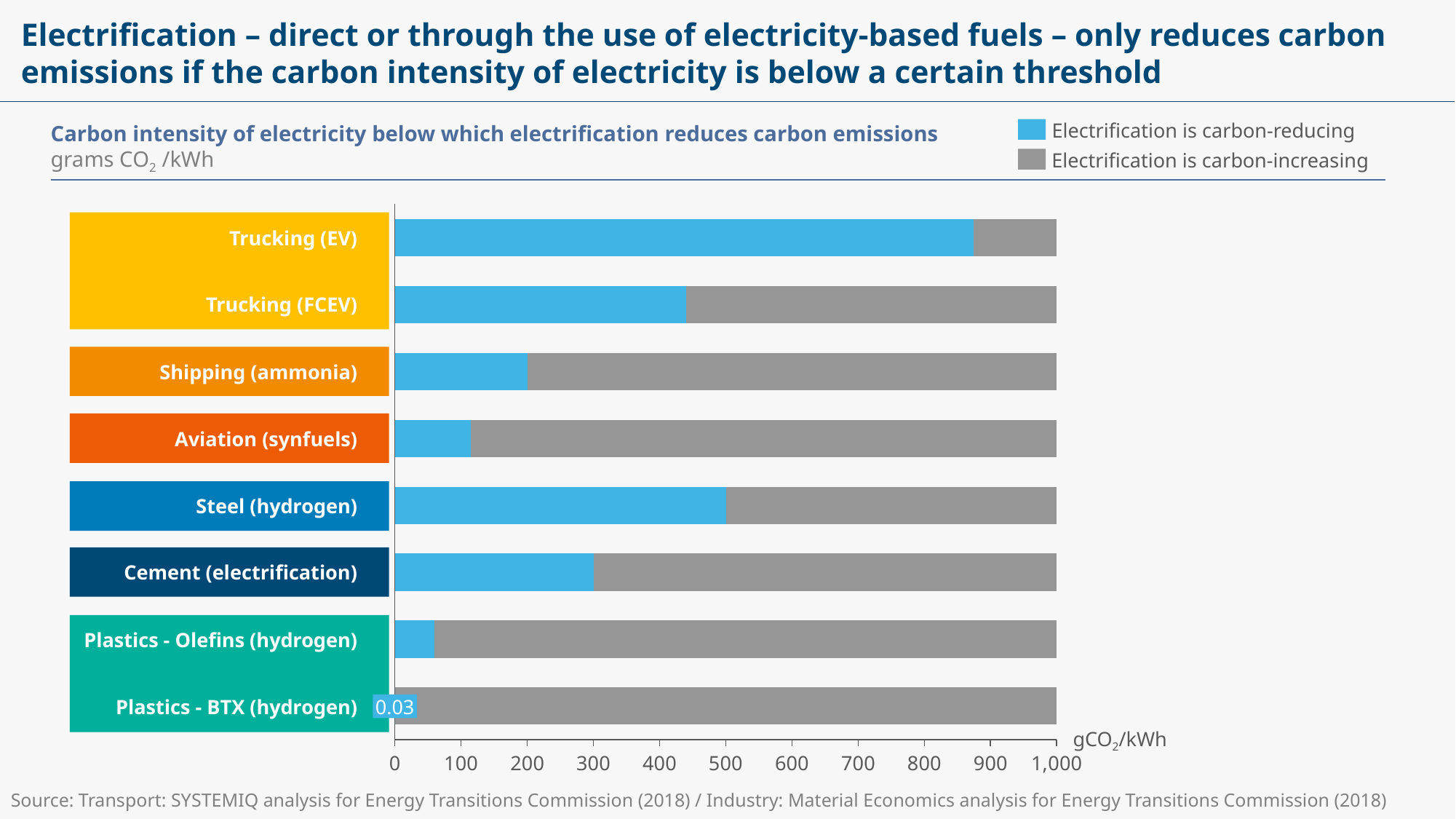
Is the carbon-reducing threshold for Aviation (synfuels) greater or less than 200 gCO2/kWh? less How many series does the legend list? 2 What kind of chart is shown on the slide? bar chart Which has the larger carbon-reducing threshold, Steel (hydrogen) or Cement (electrification)? Steel (hydrogen) Is the carbon-reducing threshold for Trucking (FCEV) greater or less than 400 gCO2/kWh? greater Is the carbon-reducing threshold for Trucking (EV) greater or less than 800 gCO2/kWh? greater Which has the larger carbon-reducing threshold, Shipping (ammonia) or Plastics - Olefins (hydrogen)? Shipping (ammonia) Which category has the highest carbon-reducing threshold (longest blue segment)? Trucking (EV) Which category has the lowest carbon-reducing threshold (shortest blue segment)? Plastics - BTX (hydrogen) What value is labelled on the blue segment for Plastics - BTX (hydrogen)? 0.03 How many categories are plotted in the chart? 8 What does the blue colour in the chart represent according to the legend? Electrification is carbon-reducing